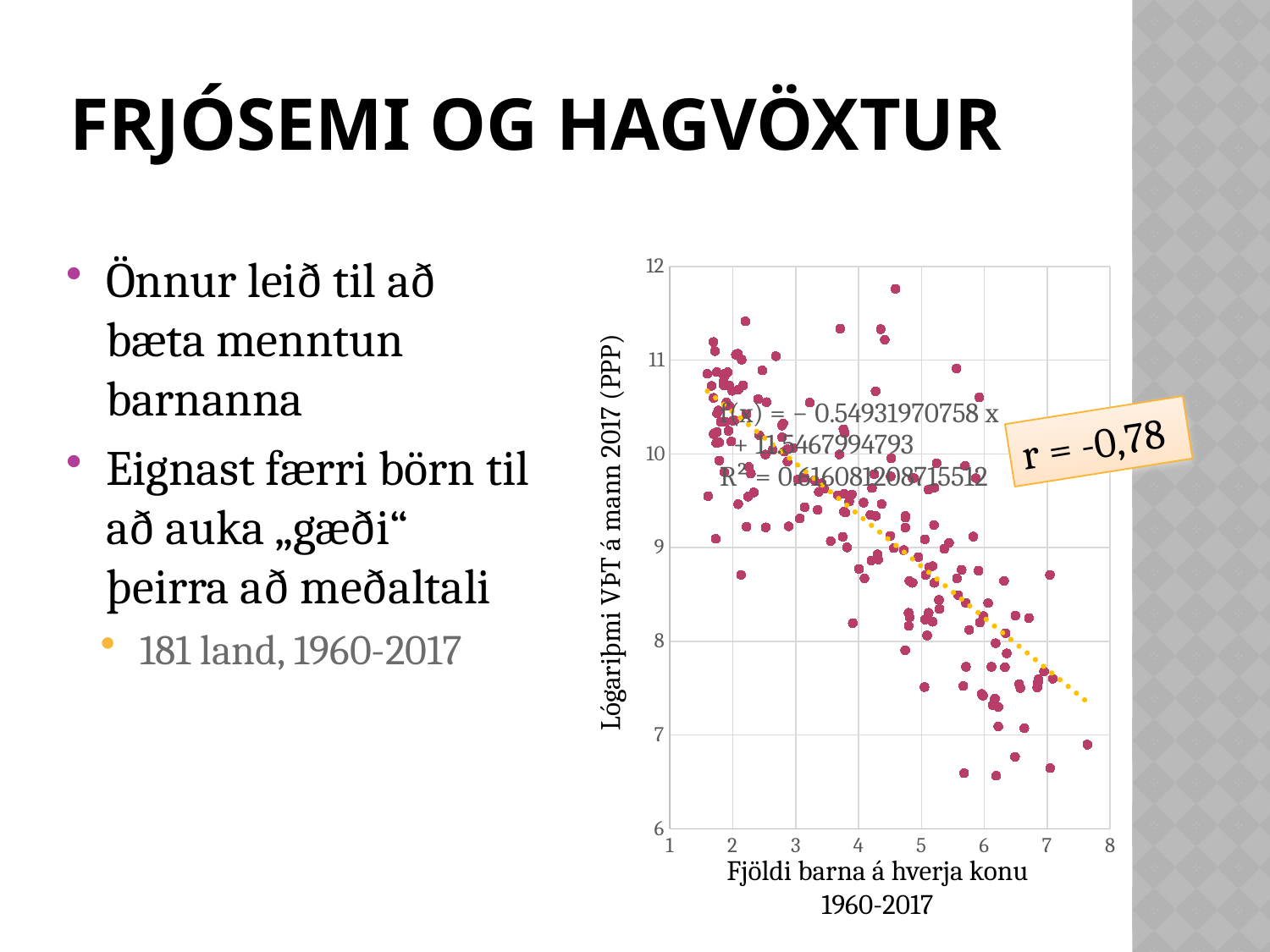
What is the highest value shown on the y axis of the chart? 12 Is the lowest value shown on the y axis greater or less than 7? less What is the slope of the fitted trend line shown in the equation on the chart? −0.54931970758 Is the correlation between the two variables in the chart positive or negative? negative What is the intercept of the fitted trend line shown in the equation on the chart? 11.5467994793 Do the plotted values rise or fall as the number of children per woman increases along the x axis? fall What kind of chart is shown on the slide? scatter plot What is the highest value shown on the x axis of the chart? 8 What is the label of the x axis of the chart? Fjöldi barna á hverja konu 1960-2017 What correlation coefficient r is shown on the chart? r = -0,78